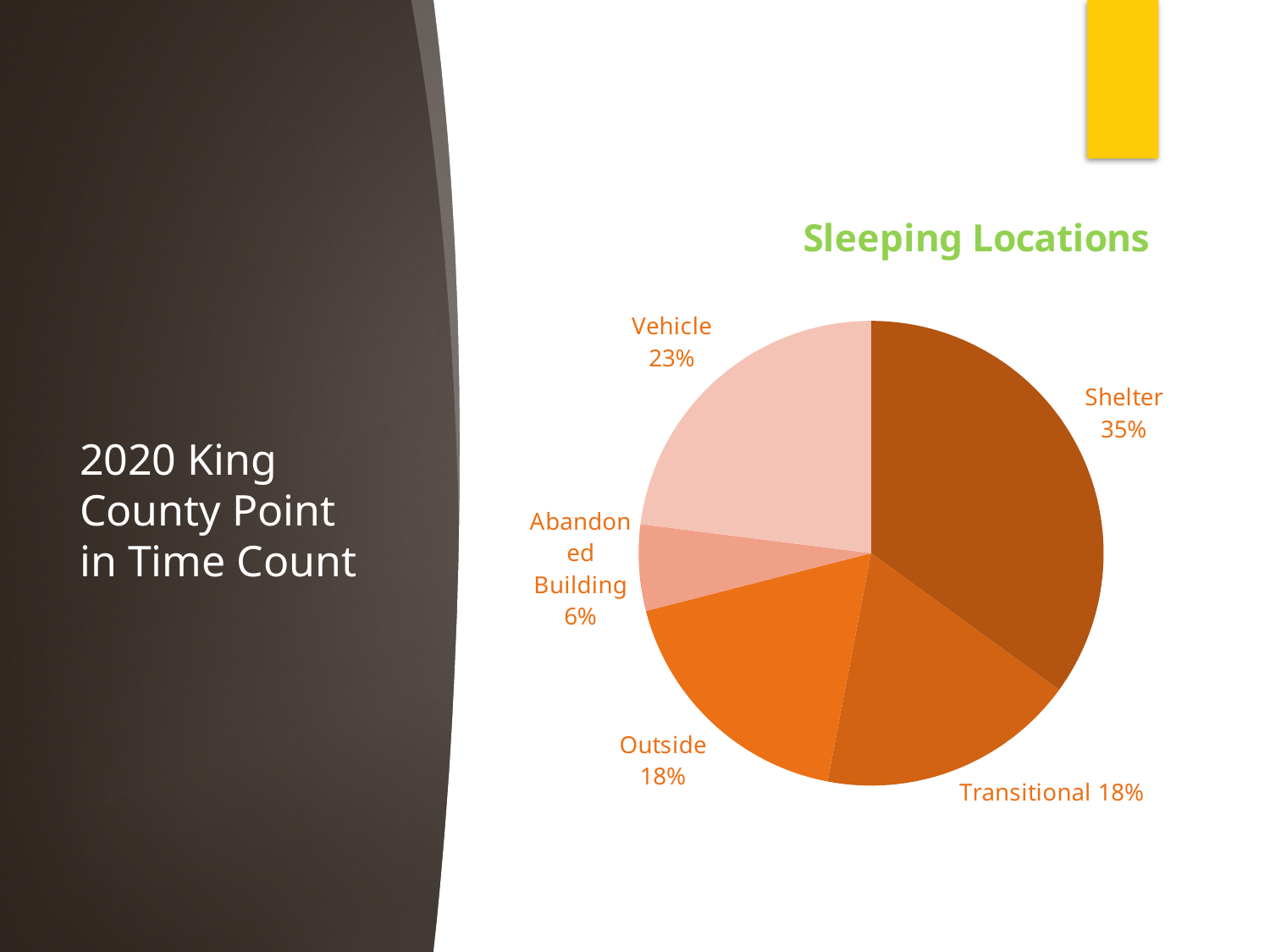
What percentage of the pie is Abandoned Building? 6% What is the title of the chart? Sleeping Locations Which sleeping location has the smallest share of the pie? Abandoned Building What percentage of the pie is Shelter? 35% Which is larger, the Vehicle share or the Transitional share? Vehicle How many slices does the pie chart have? 5 What type of chart is shown on the slide? pie chart What is the difference in percentage points between Outside and Abandoned Building? 12 What is the difference in percentage points between Shelter and Vehicle? 12 What percentage of the pie is Vehicle? 23% Which sleeping location has the largest share of the pie? Shelter What percentage of the pie is Outside? 18%